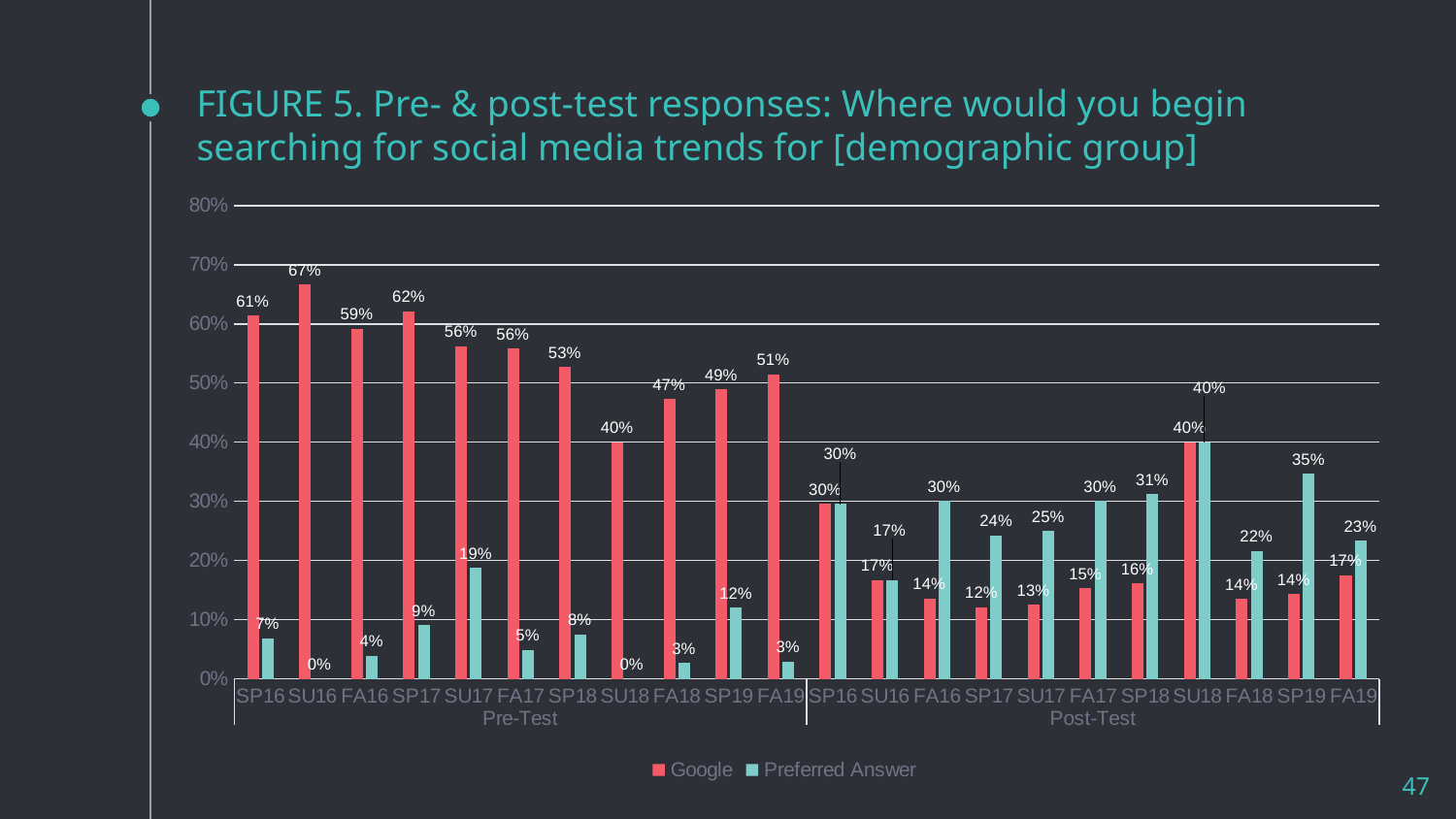
Which Pre-Test term has the highest Google value? SU16 What is the Google value for SU18 in the Post-Test group? 40% How many terms are shown in the Pre-Test group? 11 In the Post-Test group, which is larger for FA16: Google or Preferred Answer? Preferred Answer Which Post-Test term has the lowest Google value? SP17 What is the Preferred Answer value for SP19 in the Post-Test group? 35% What is the Google value for SU16 in the Pre-Test group? 67% How many series does the legend list? 2 What type of chart is shown on the slide? Bar chart What colour represents the Google series? Red Which Pre-Test term has the highest Preferred Answer value? SU17 What is the difference between the Google and Preferred Answer values for SP16 in the Pre-Test group? 54%